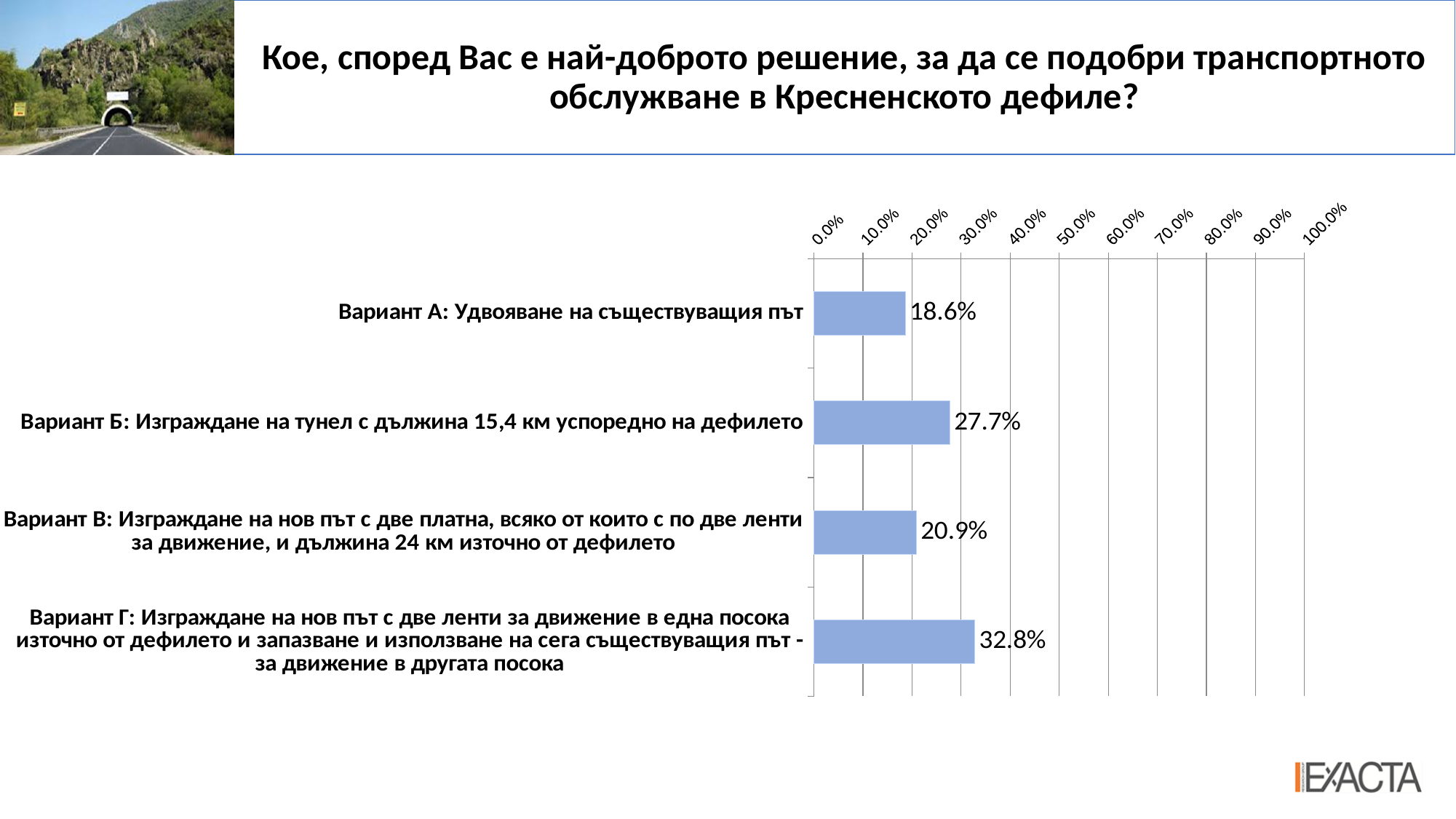
Which option has the lowest value? Вариант А Which is larger, the value for Вариант Б or the value for Вариант В? Вариант Б What is the difference between the values for Вариант Г and Вариант А? 14.2% What kind of chart is shown on the slide? bar chart What is the value for Вариант А: Удвояване на съществуващия път? 18.6% What is the difference between the values for Вариант Б and Вариант В? 6.8% What is the value for Вариант Г (new two-lane road in one direction east of the gorge, keeping the existing road for the other direction)? 32.8% Which option has the highest value? Вариант Г Is the value for Вариант Г greater or less than 30.0%? greater How many options (categories) are shown in the chart? 4 What is the value for Вариант Б: Изграждане на тунел с дължина 15,4 км успоредно на дефилето? 27.7% What is the value for Вариант В (new road with two carriageways, 24 km east of the gorge)? 20.9%